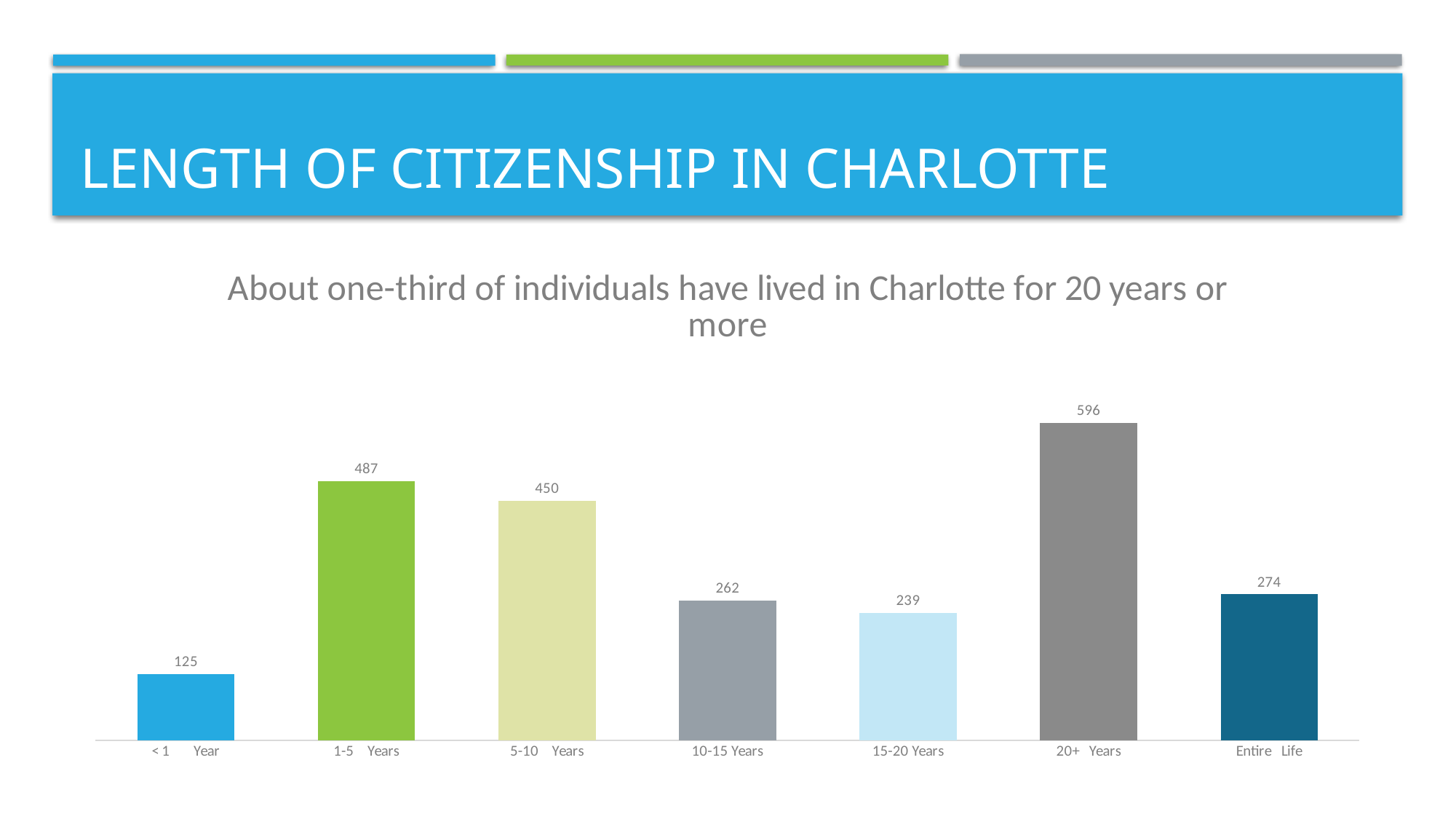
What is the value for the 15-20 Years category? 239 What kind of chart is shown on the slide? Bar chart What is the difference between the values for 1-5 Years and 5-10 Years? 37 What is the value for the < 1 Year category? 125 What is the value for the 20+ Years category? 596 What is the difference between the values for 20+ Years and Entire Life? 322 Which is larger, the value for 10-15 Years or the value for 15-20 Years? 10-15 Years What is the title of the slide? LENGTH OF CITIZENSHIP IN CHARLOTTE Which category has the highest value? 20+ Years How many categories are shown in the chart? 7 What is the value for the Entire Life category? 274 Which category has the lowest value? < 1 Year